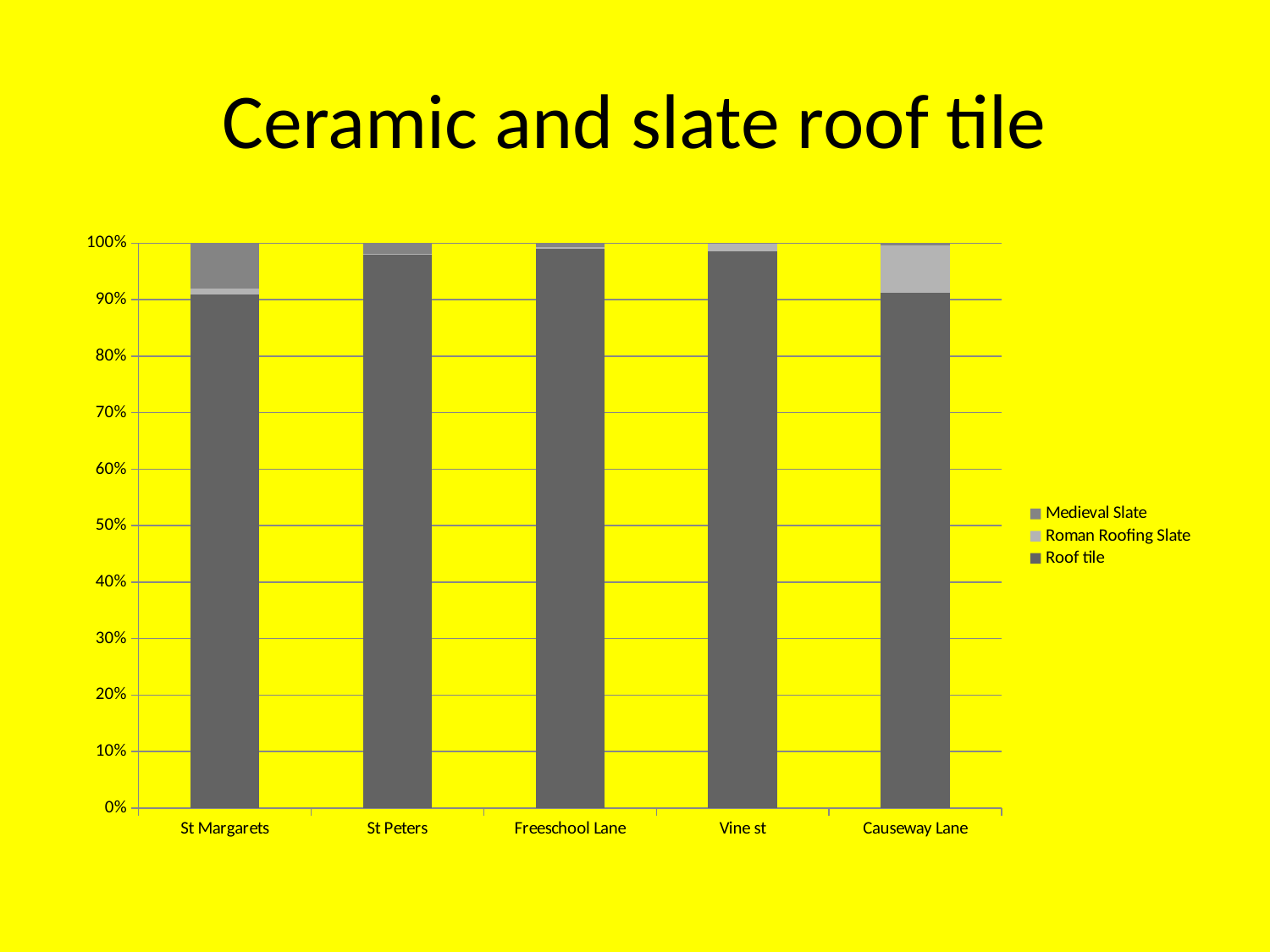
Is the Roof tile value for Freeschool Lane greater or less than 90%? greater What is the title of the chart? Ceramic and slate roof tile How many categories are shown on the x axis? 5 What does each stacked bar total? 100% How many series does the legend list? 3 What kind of chart is shown on the slide? stacked bar chart Is the Roof tile value for St Peters greater or less than 90%? greater Which category has the largest Medieval Slate share? St Margarets Which category has the largest Roman Roofing Slate share? Causeway Lane Is the Roof tile value for Causeway Lane greater or less than 80%? greater Which series is listed first in the legend? Medieval Slate Which is larger, the Roof tile value for St Peters or for St Margarets? St Peters